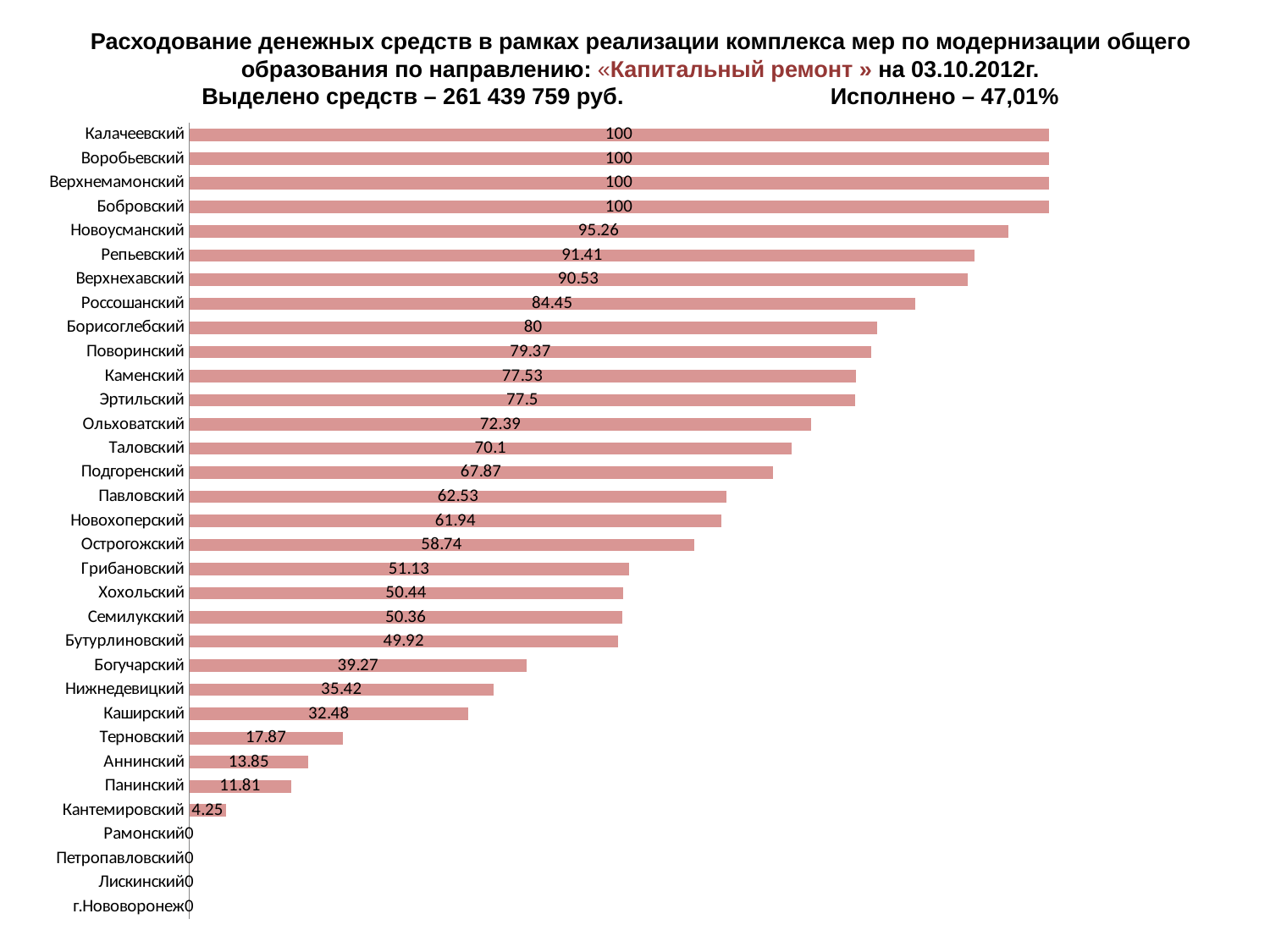
Which is larger, the value for Терновский or the value for Аннинский? Терновский Which is larger, the value for Таловский or the value for Подгоренский? Таловский What is the value for Кантемировский? 4.25 What is the value for Острогожский? 58.74 What is the value for Новоусманский? 95.26 What is the value for Каширский? 32.48 What is the difference between the values for Россошанский and Борисоглебский? 4.45 How many categories are shown on the chart? 33 How many districts have a value of 0? 4 How many districts have a value of 100? 4 What kind of chart is shown on the slide? Bar chart What is the difference between the values for Богучарский and Нижнедевицкий? 3.85